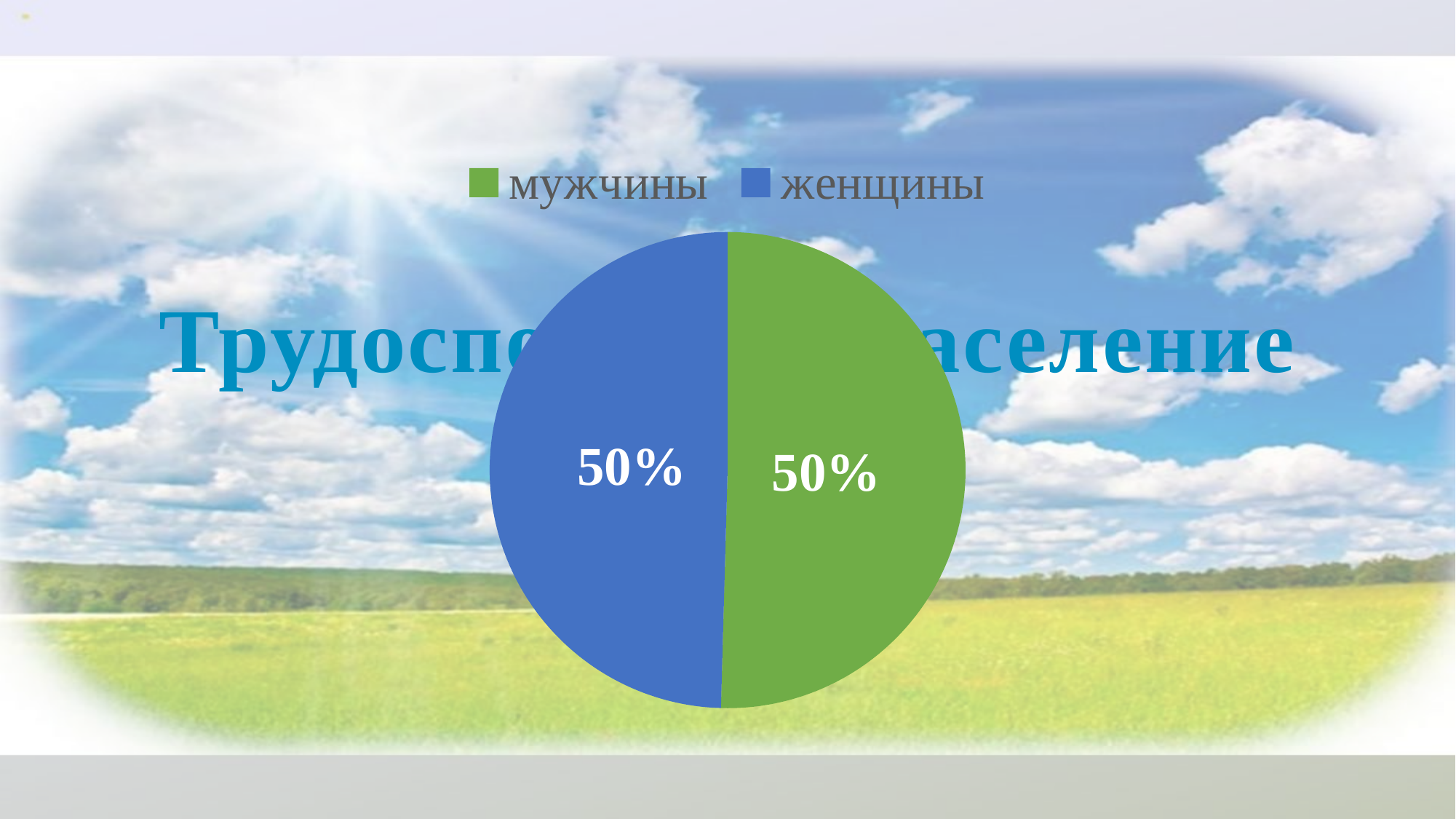
What share of the pie does мужчины have? 50% How many slices does the pie chart have? 2 How many entries does the legend list? 2 What colour is the slice for женщины? blue What is the total of the two slices shown in the pie chart? 100% What kind of chart is shown on the slide? pie chart What colour is the slice for мужчины? green What is the difference between the shares for мужчины and женщины? 0% What share of the pie does женщины have? 50%